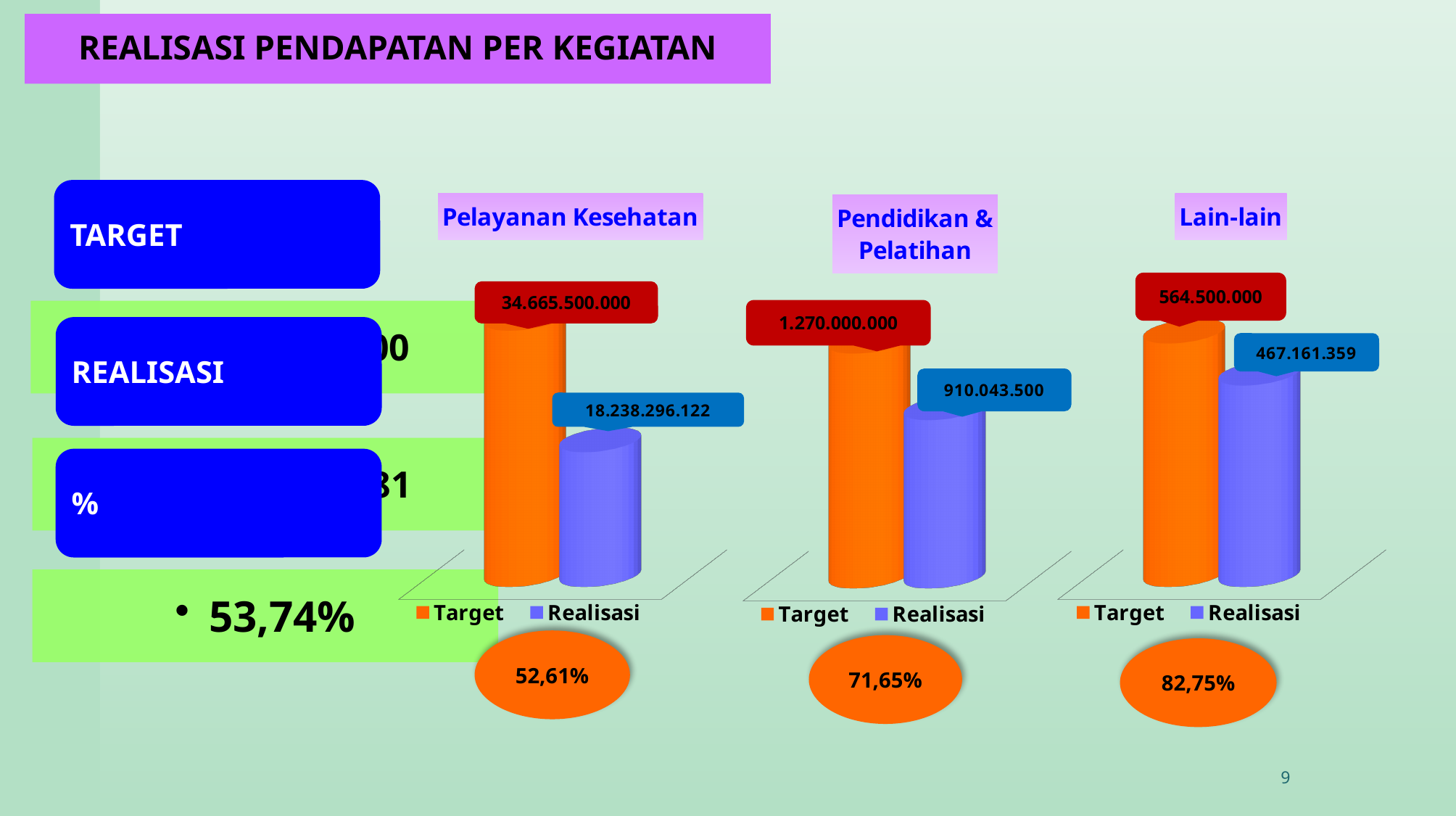
In the Pendidikan & Pelatihan chart, what is the difference between the Target and Realisasi values? 359.956.500 In the Pelayanan Kesehatan chart, what is the value of the Target bar? 34.665.500.000 In the Pelayanan Kesehatan chart, what is the value of the Realisasi bar? 18.238.296.122 In the Lain-lain chart, what is the value of the Realisasi bar? 467.161.359 In the Pendidikan & Pelatihan chart, what is the value of the Target bar? 1.270.000.000 What kind of chart is the Pendidikan & Pelatihan chart? Bar chart In the Pelayanan Kesehatan chart, what colour is the Target bar? Orange In the Pendidikan & Pelatihan chart, what is the value of the Realisasi bar? 910.043.500 In the Pelayanan Kesehatan chart, which series has the larger value, Target or Realisasi? Target In the Lain-lain chart, what is the value of the Target bar? 564.500.000 How many series does the legend of the Lain-lain chart list? 2 In the Lain-lain chart, what is the difference between the Target and Realisasi values? 97.338.641